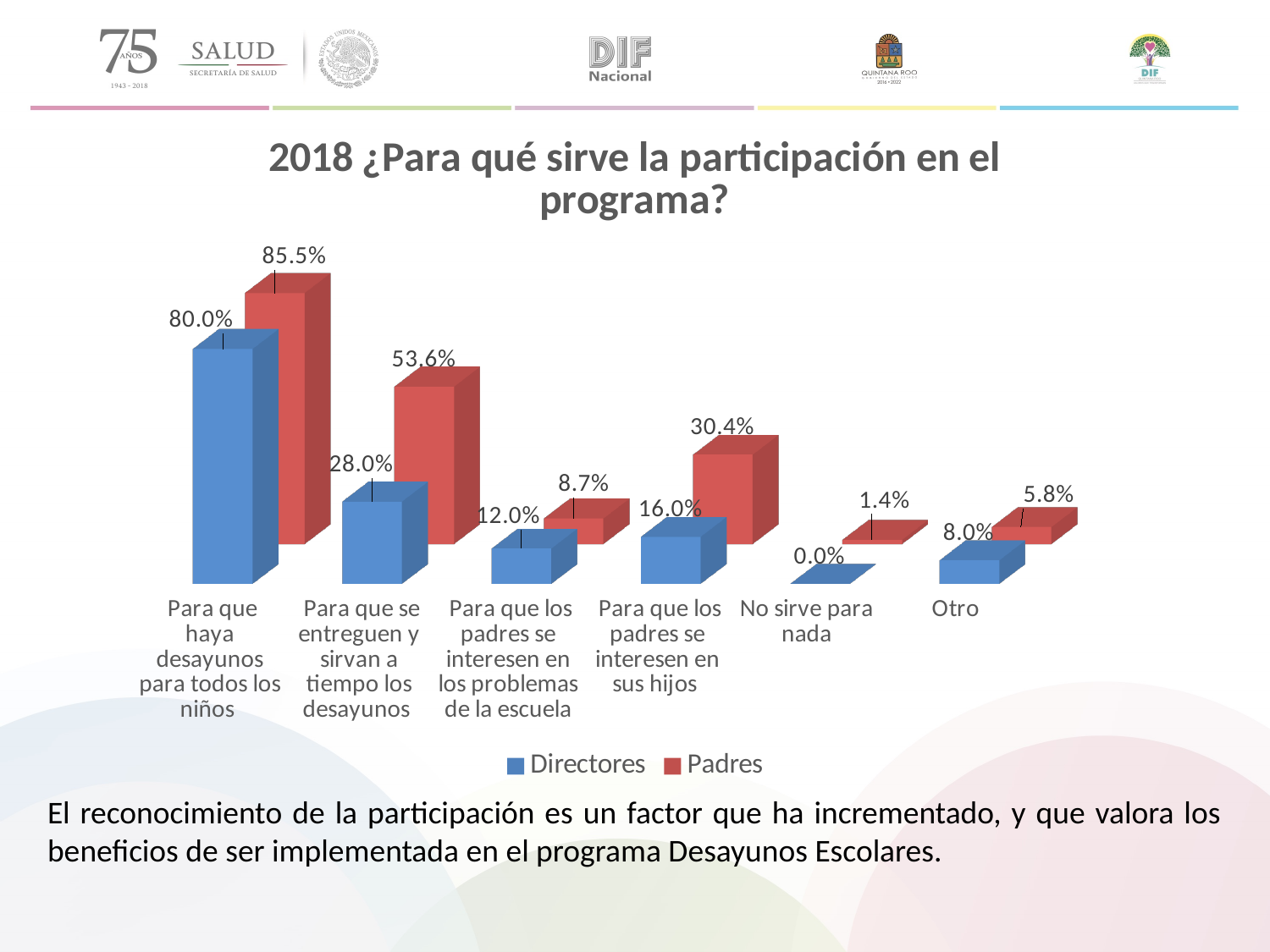
In the category "Para que los padres se interesen en sus hijos", which series has the larger value, Directores or Padres? Padres How many categories are shown on the x axis of the chart? 6 What is the difference between the Padres and Directores values for "Para que se entreguen y sirvan a tiempo los desayunos"? 25.6% What is the value for Padres in the category "Para que se entreguen y sirvan a tiempo los desayunos"? 53.6% What type of chart is shown on the slide? Bar chart Which category has the lowest value for Directores? No sirve para nada What is the value for Padres in the category "Otro"? 5.8% What is the value for Directores in the category "No sirve para nada"? 0.0% Which category has the highest value for Padres? Para que haya desayunos para todos los niños What is the value for Directores in the category "Para que haya desayunos para todos los niños"? 80.0% What is the value for Padres in the category "Para que haya desayunos para todos los niños"? 85.5% How many series does the legend list? 2